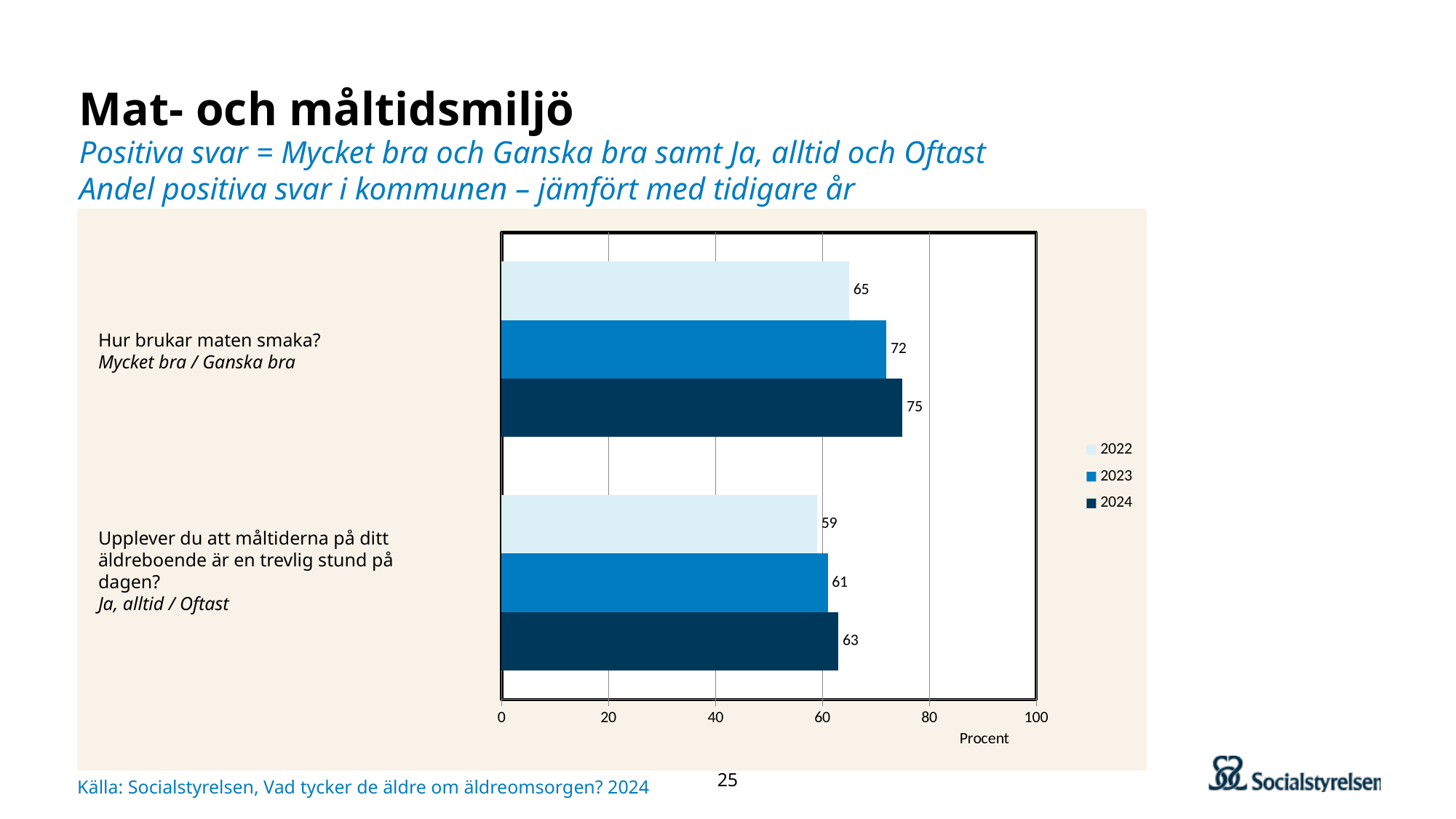
How many series does the legend list? 3 What kind of chart is shown on the slide? Bar chart What is the value for 2024 for the question "Hur brukar maten smaka?"? 75 Do the values for "Hur brukar maten smaka?" rise or fall from 2022 to 2024? Rise Which is larger: the 2022 value for "Hur brukar maten smaka?" or the 2024 value for "Upplever du att måltiderna på ditt äldreboende är en trevlig stund på dagen?"? The 2022 value for "Hur brukar maten smaka?" Which year has the highest value for "Hur brukar maten smaka?"? 2024 Is the 2023 value for "Upplever du att måltiderna på ditt äldreboende är en trevlig stund på dagen?" greater or less than 80? less Which year has the lowest value for "Upplever du att måltiderna på ditt äldreboende är en trevlig stund på dagen?"? 2022 What is the value for 2023 for the question "Hur brukar maten smaka?"? 72 What is the difference between the 2024 and 2022 values for "Hur brukar maten smaka?"? 10 What is the value for 2022 for the question "Upplever du att måltiderna på ditt äldreboende är en trevlig stund på dagen?"? 59 What is the difference between the 2024 and 2023 values for "Upplever du att måltiderna på ditt äldreboende är en trevlig stund på dagen?"? 2